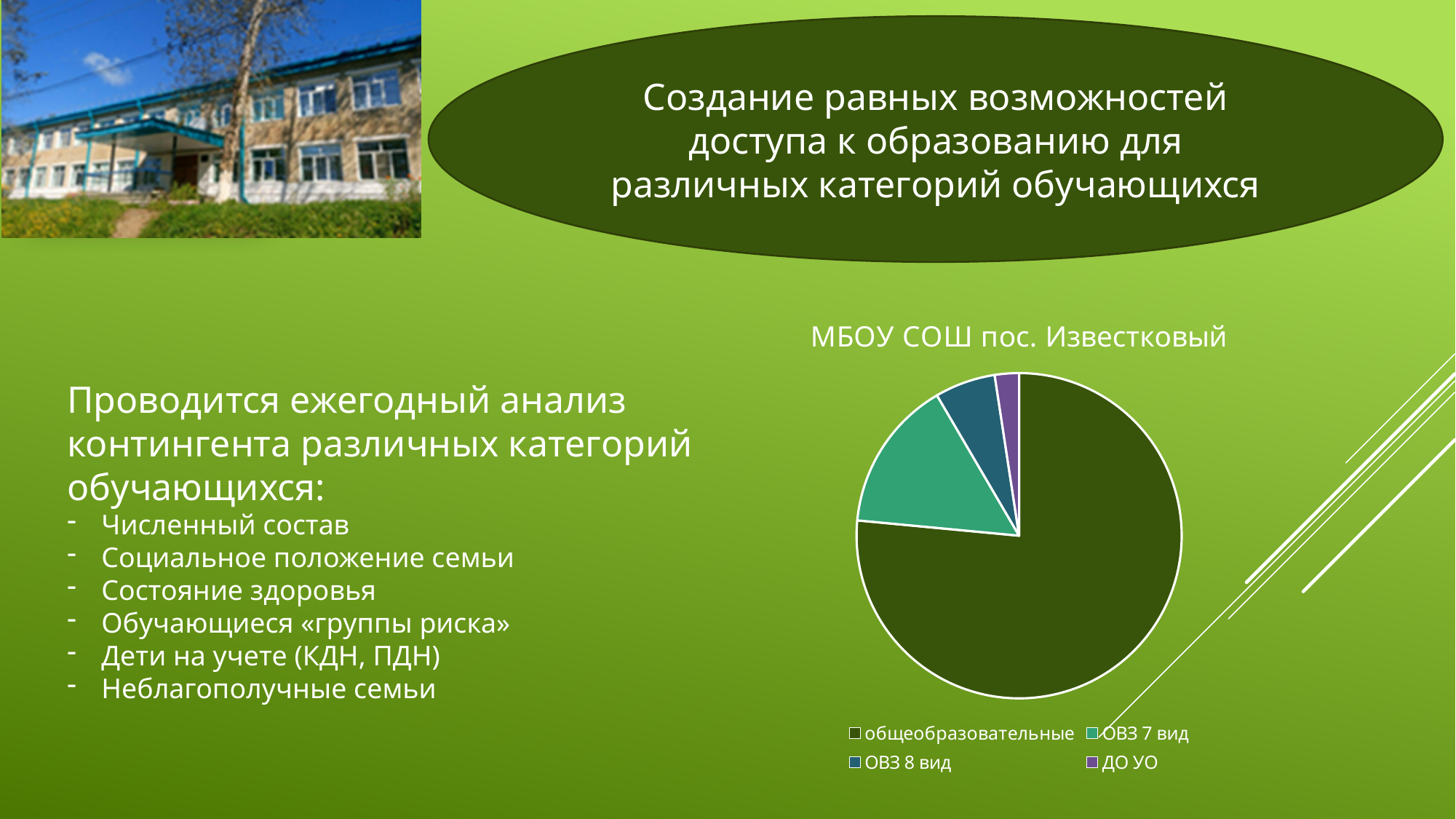
Which category has the second-largest slice in the pie chart? ОВЗ 7 вид What is the title of the pie chart? МБОУ СОШ пос. Известковый Which slice is larger in the pie chart: ОВЗ 7 вид or ОВЗ 8 вид? ОВЗ 7 вид What kind of chart is shown on the slide? pie chart Which category has the smallest slice in the pie chart? ДО УО Which category is shown in purple in the pie chart? ДО УО How many entries does the legend of the pie chart list? 4 Which slice is larger in the pie chart: ОВЗ 8 вид or ДО УО? ОВЗ 8 вид How many slices does the pie chart have? 4 Which slice is larger in the pie chart: общеобразовательные or ОВЗ 7 вид? общеобразовательные Which category has the largest slice in the pie chart? общеобразовательные